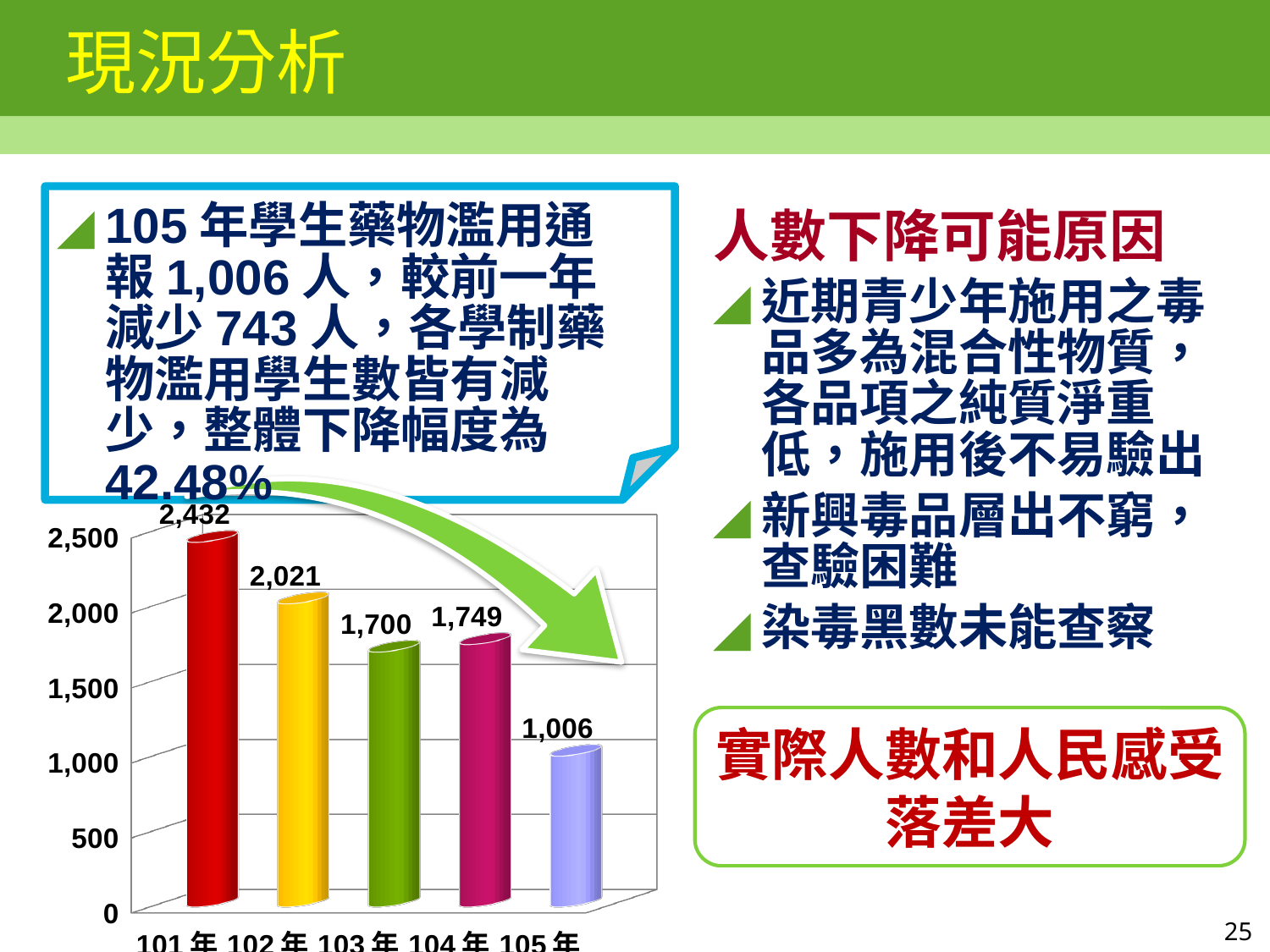
What is the value for 101年? 2,432 What is the difference between the values for 104年 and 105年? 743 How many years are shown on the x axis? 5 What is the value for 105年? 1,006 Which is larger, the value for 103年 or the value for 104年? 104年 What kind of chart is shown on the slide? bar chart What is the difference between the values for 101年 and 102年? 411 Which year has the lowest value? 105年 Is the value for 102年 greater or less than 2,000? greater What is the value for 103年? 1,700 Which year has the highest value? 101年 Do the values generally rise or fall from 101年 to 105年? fall